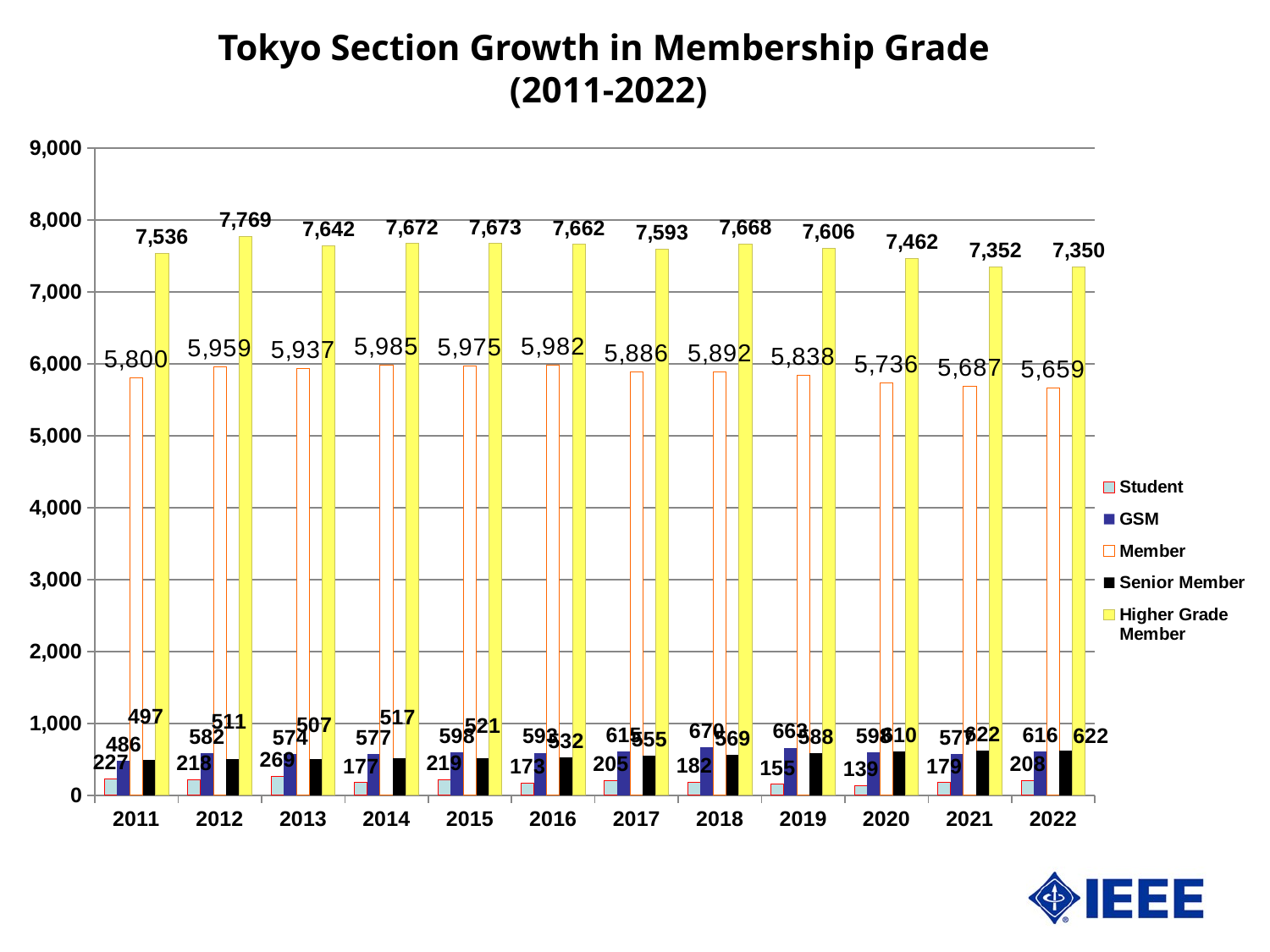
What is the Member value for 2014? 5,985 In which year is the Member value lowest? 2022 Does the Higher Grade Member value rise or fall from 2018 to 2022? Fall How many years are shown on the x axis? 12 Is the Member value for 2011 greater or less than 6,000? less How many series does the legend list? 5 In which year is the Higher Grade Member value highest? 2012 Which year has the larger Student value, 2013 or 2020? 2013 What is the Higher Grade Member value for 2012? 7,769 What kind of chart is shown on the slide? Bar chart What is the Senior Member value for 2011? 497 What is the difference between the Higher Grade Member values for 2011 and 2022? 186